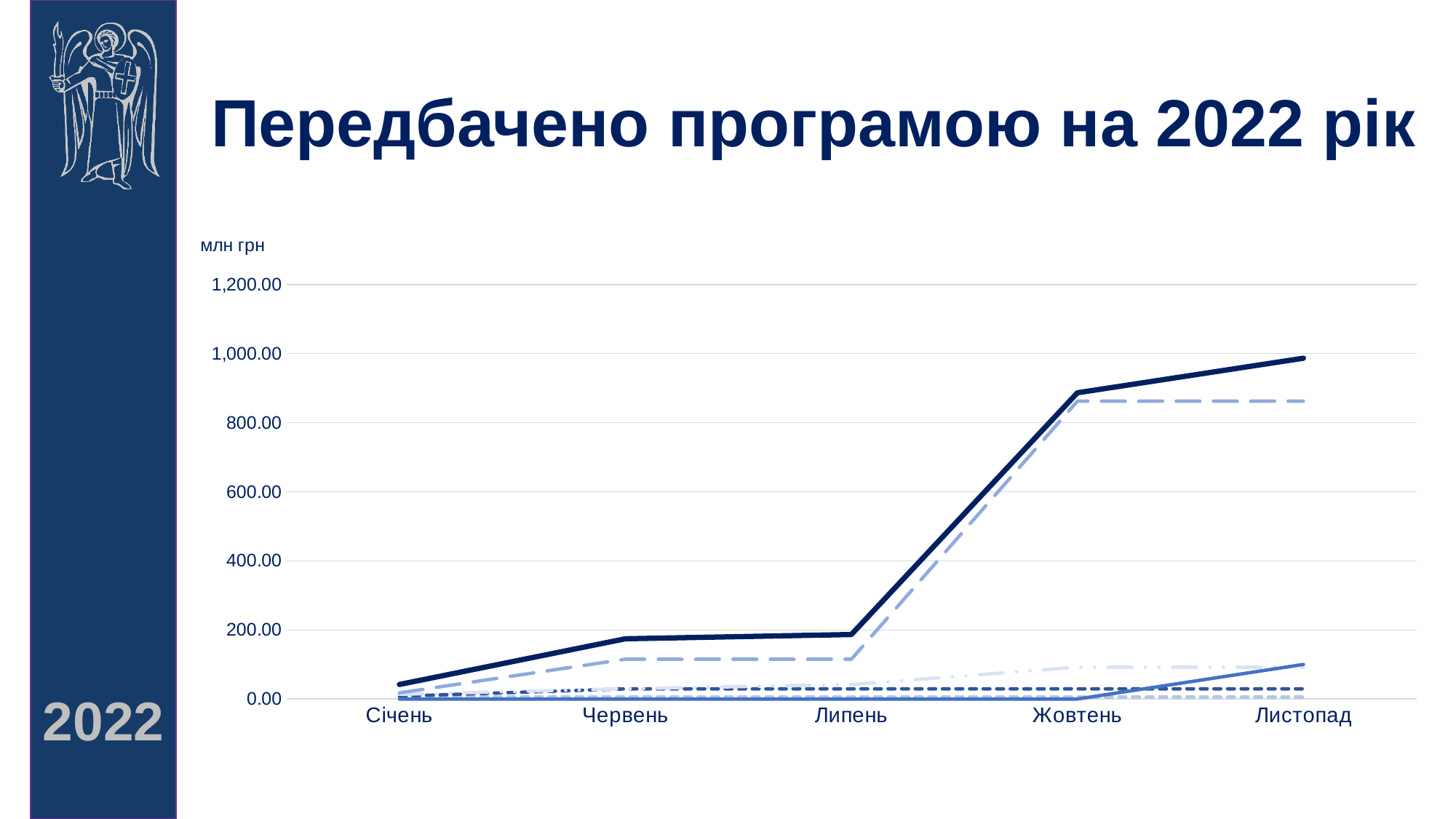
Is the value of the thick solid dark blue line at Липень greater or less than 200? less What kind of chart is shown on the slide? line chart What unit is shown above the y axis of the chart? млн грн For the thick solid dark blue line, which is larger: the value at Жовтень or the value at Липень? Жовтень At which x-axis category does the thick solid dark blue line have its lowest value? Січень Is the value of the thick solid dark blue line at Листопад greater or less than 800? greater How many categories are shown on the x axis of the chart? 5 Is the value of the thick solid dark blue line at Жовтень greater or less than 600? greater Does the thick solid dark blue line rise or fall from Січень to Листопад? rise What is the title of the slide containing the chart? Передбачено програмою на 2022 рік At which x-axis category does the thick solid dark blue line reach its highest value? Листопад